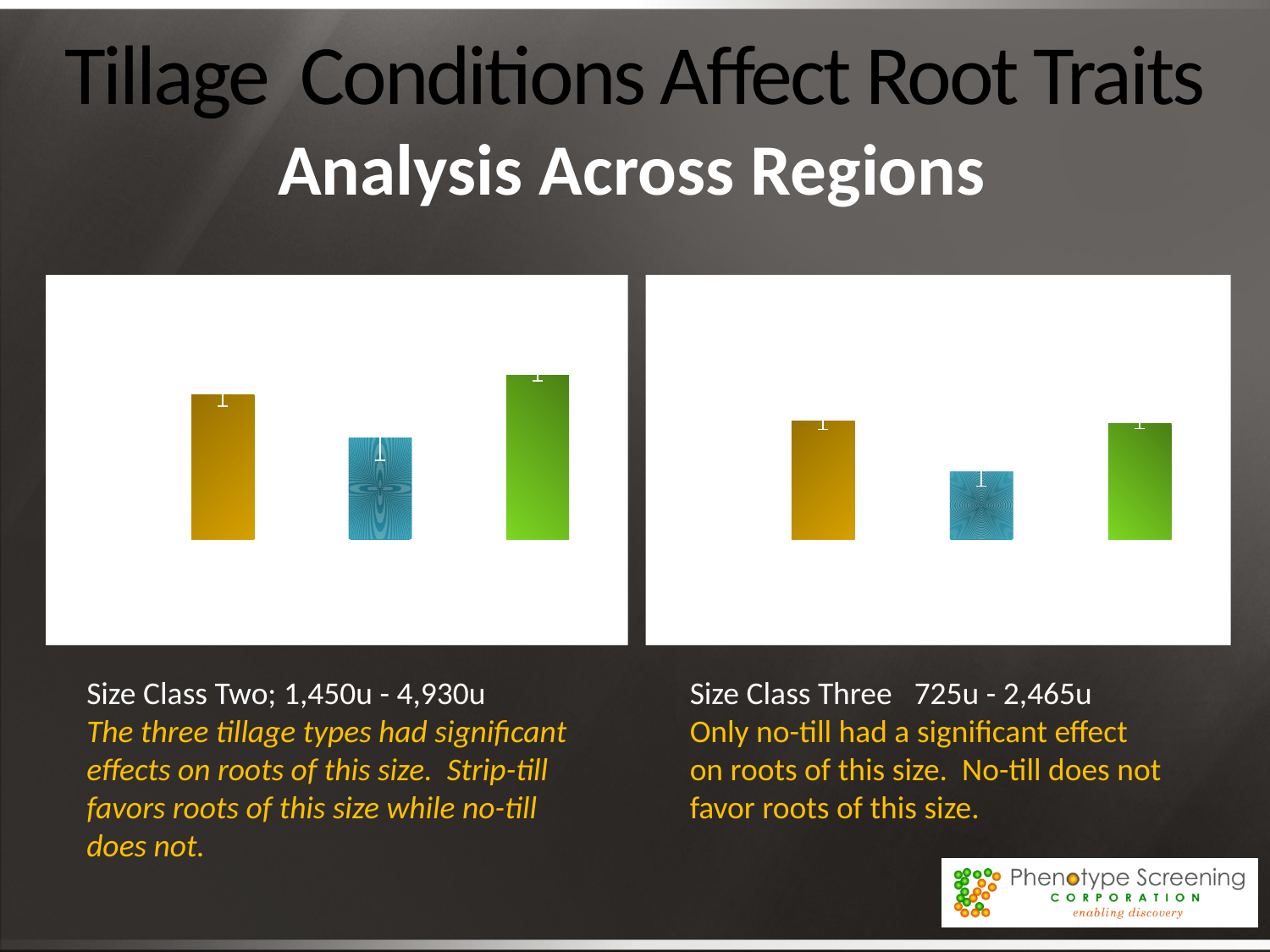
In the left chart, is the gold bar taller or shorter than the blue bar? taller How many bars are plotted in the right chart? 3 In the right chart, which bar is the shortest: the gold, the blue, or the green one? blue What three colours are used for the bars in each chart? gold, blue and green What kind of chart is the left chart on the slide? bar chart In the left chart, which bar is the tallest: the gold, the blue, or the green one? green How many bars are plotted in the left chart? 3 What kind of chart is the right chart on the slide? bar chart How many charts are shown on the slide? 2 In the left chart, is the green bar taller or shorter than the gold bar? taller In the right chart, is the green bar taller or shorter than the blue bar? taller In the left chart, which bar is the shortest: the gold, the blue, or the green one? blue